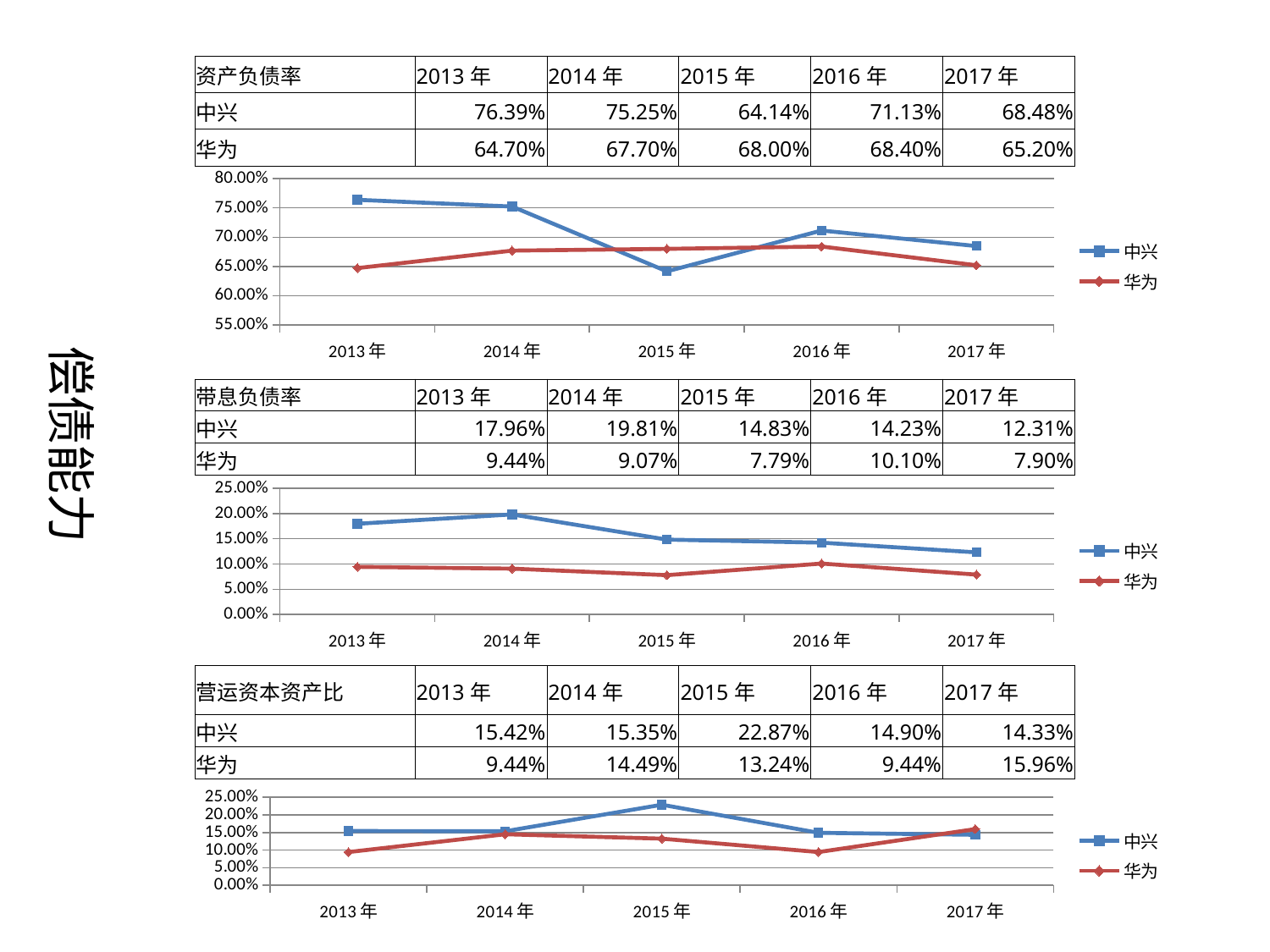
In the bottom chart (营运资本资产比), which year has the highest value for 华为? 2017年 What kind of chart is the top chart (资产负债率)? line chart In the middle chart (带息负债率), what is the value for 华为 in 2016年? 10.10% In the top chart (资产负债率), what is the difference between 中兴 and 华为 in 2013年? 11.69% In the middle chart (带息负债率), which year has the lowest value for 华为? 2015年 In the middle chart (带息负债率), is the value for 中兴 in 2014年 greater or less than 15.00%? greater In the top chart (资产负债率), which is larger in 2015年, 中兴 or 华为? 华为 In the top chart (资产负债率), which year has the highest value for 中兴? 2013年 In the middle chart (带息负债率), does the 中兴 line rise or fall from 2014年 to 2017年? fall In the bottom chart (营运资本资产比), what is the value for 中兴 in 2015年? 22.87% In the top chart (资产负债率), what is the value for 中兴 in 2015年? 64.14% How many series does the legend of the bottom chart (营运资本资产比) list? 2